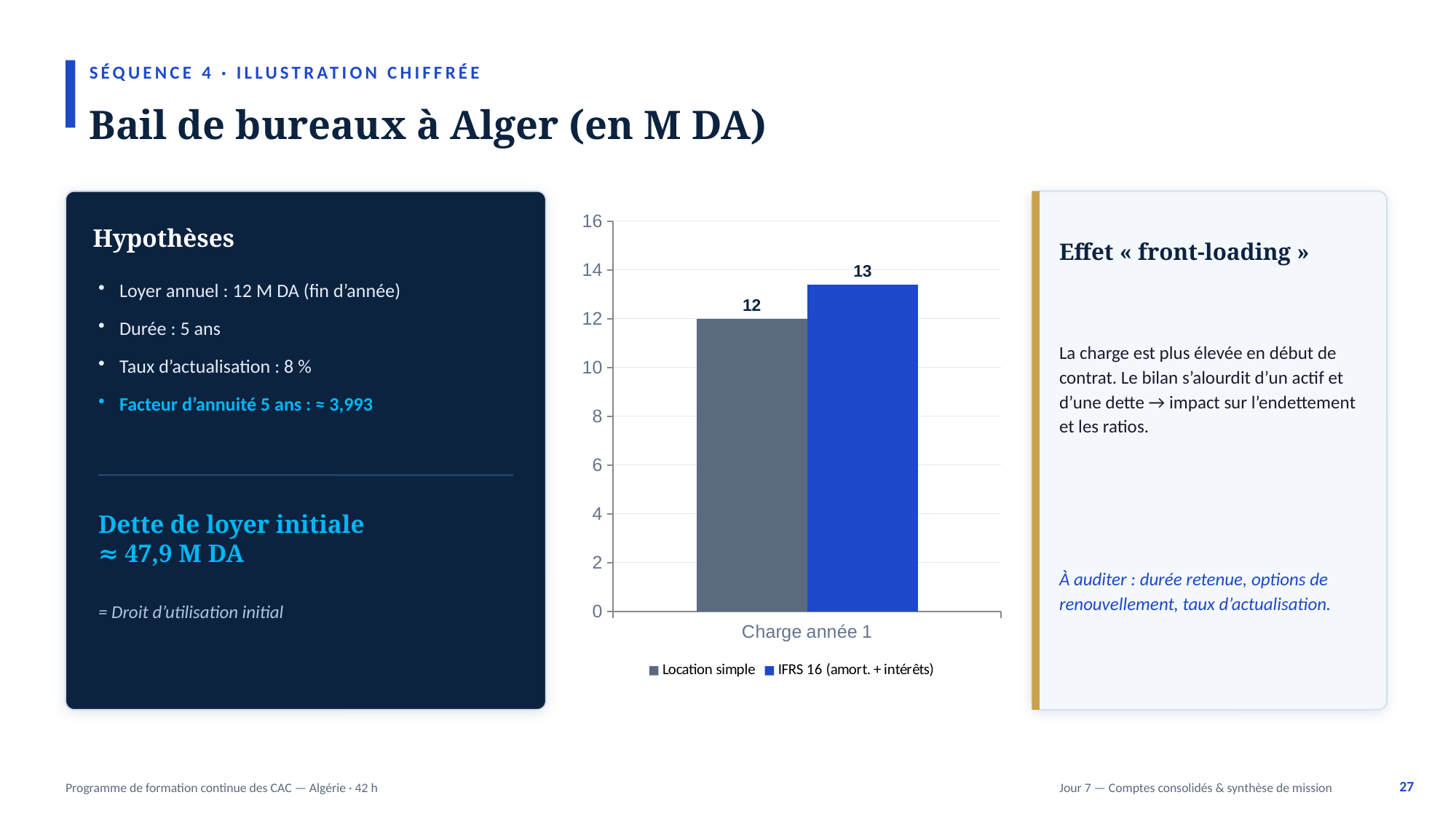
Is the Location simple value larger or smaller than the IFRS 16 (amort. + intérêts) value? smaller How many categories are shown on the x axis of the chart? 1 What is the difference between the IFRS 16 (amort. + intérêts) value and the Location simple value? 1 What type of chart is shown on the slide? bar chart What is the label of the category on the x axis? Charge année 1 Which series has the lower value for Charge année 1? Location simple Which colour represents the IFRS 16 (amort. + intérêts) series in the legend? blue What is the value of the Location simple bar for Charge année 1? 12 How many series does the chart legend list? 2 What is the value of the IFRS 16 (amort. + intérêts) bar for Charge année 1? 13 Is the value for IFRS 16 (amort. + intérêts) greater or less than 10? greater Which series has the higher value for Charge année 1? IFRS 16 (amort. + intérêts)